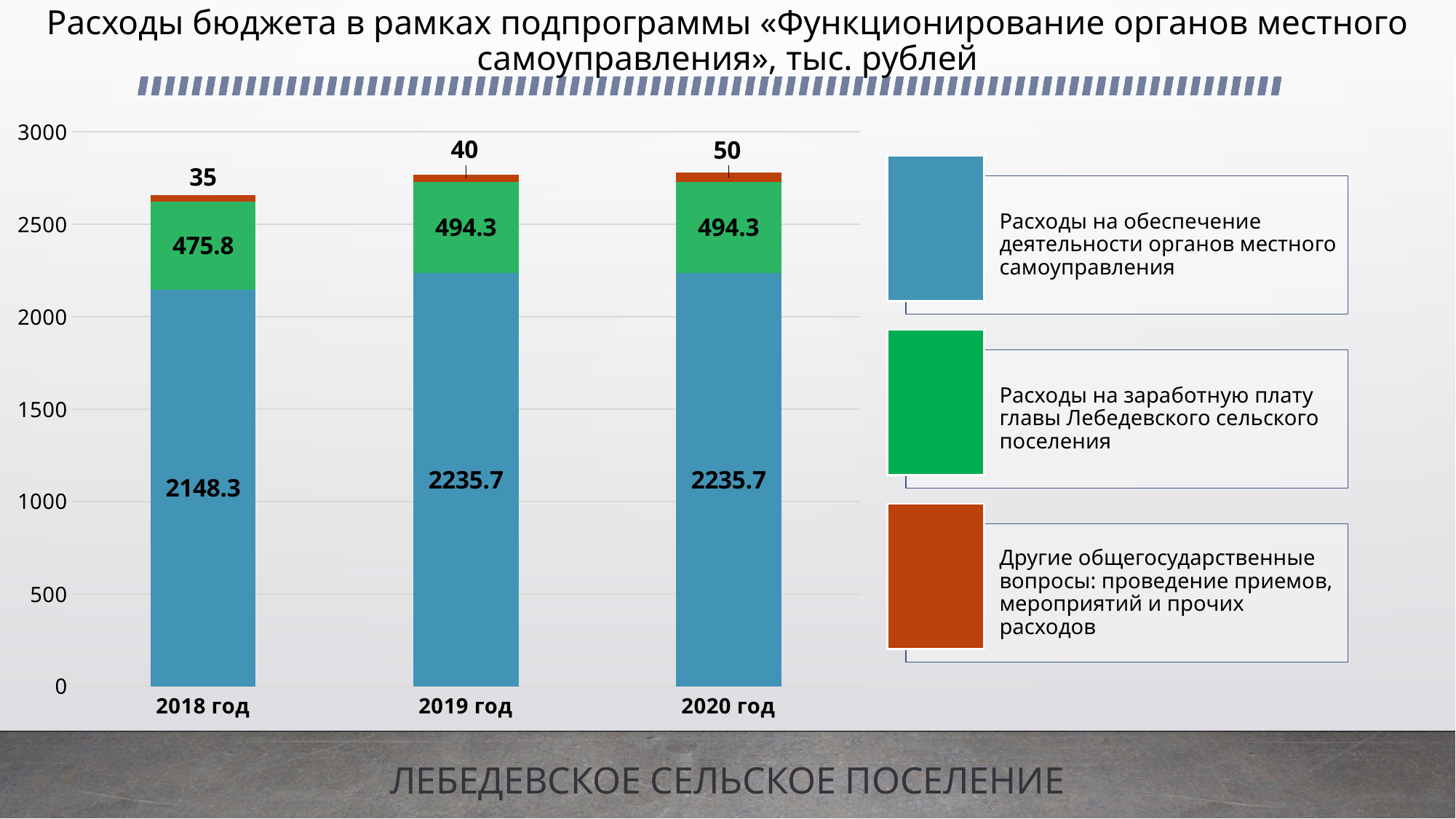
Какова общая сумма расходов за 2018 год (сумма всех сегментов столбца)? 2659.1 Каково значение расходов на заработную плату главы Лебедевского сельского поселения в 2019 году? 494.3 Как меняется значение других общегосударственных вопросов с 2018 по 2020 год — растёт или падает? растёт Какова общая сумма расходов за 2020 год (сумма всех сегментов столбца)? 2780 В каком году значение других общегосударственных вопросов наибольшее? 2020 год Сколько рядов данных перечислено в легенде диаграммы? 3 Каково значение расходов на обеспечение деятельности органов местного самоуправления в 2018 году? 2148.3 На сколько расходы на обеспечение деятельности органов местного самоуправления в 2019 году больше, чем в 2018 году? 87.4 В каком году значение других общегосударственных вопросов наименьшее? 2018 год Каково значение других общегосударственных вопросов в 2020 году? 50 Сколько категорий (лет) показано на диаграмме? 3 Какой тип диаграммы показан на слайде? столбчатая диаграмма с накоплением